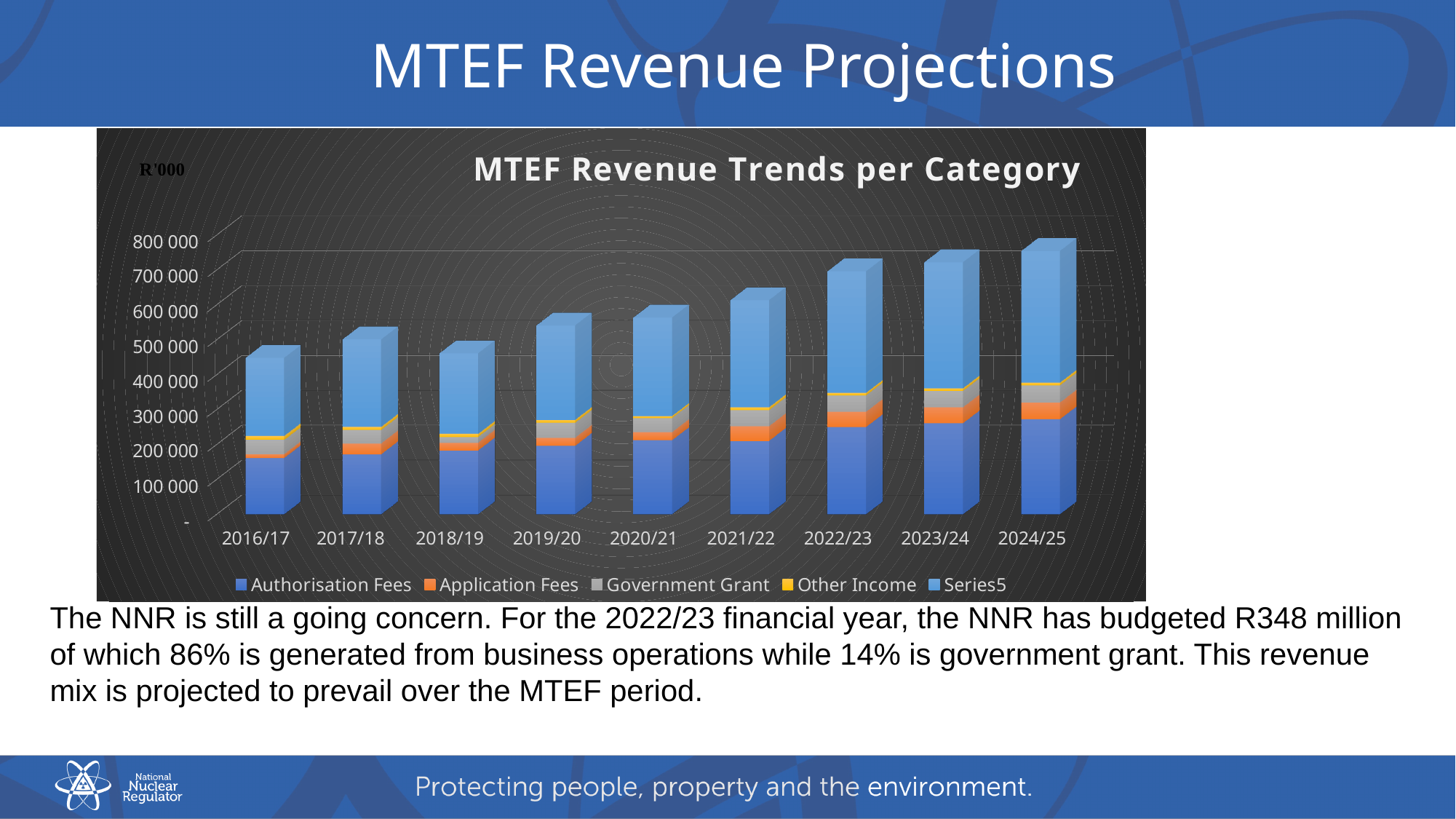
What kind of chart is shown on the slide? bar chart What unit label is shown at the top left of the chart's value axis? R'000 Which total is larger, 2024/25 or 2016/17? 2024/25 Is the Authorisation Fees value for 2024/25 greater or less than 200 000? greater What is the title of the chart? MTEF Revenue Trends per Category Do the total stacked bars generally rise or fall from 2019/20 to 2024/25? rise Which financial year has the highest total stacked bar? 2024/25 Is the total stacked bar for 2016/17 greater or less than 600 000? less Is the total stacked bar for 2024/25 greater or less than 700 000? greater How many series does the chart legend list? 5 How many financial years are shown on the x axis of the chart? 9